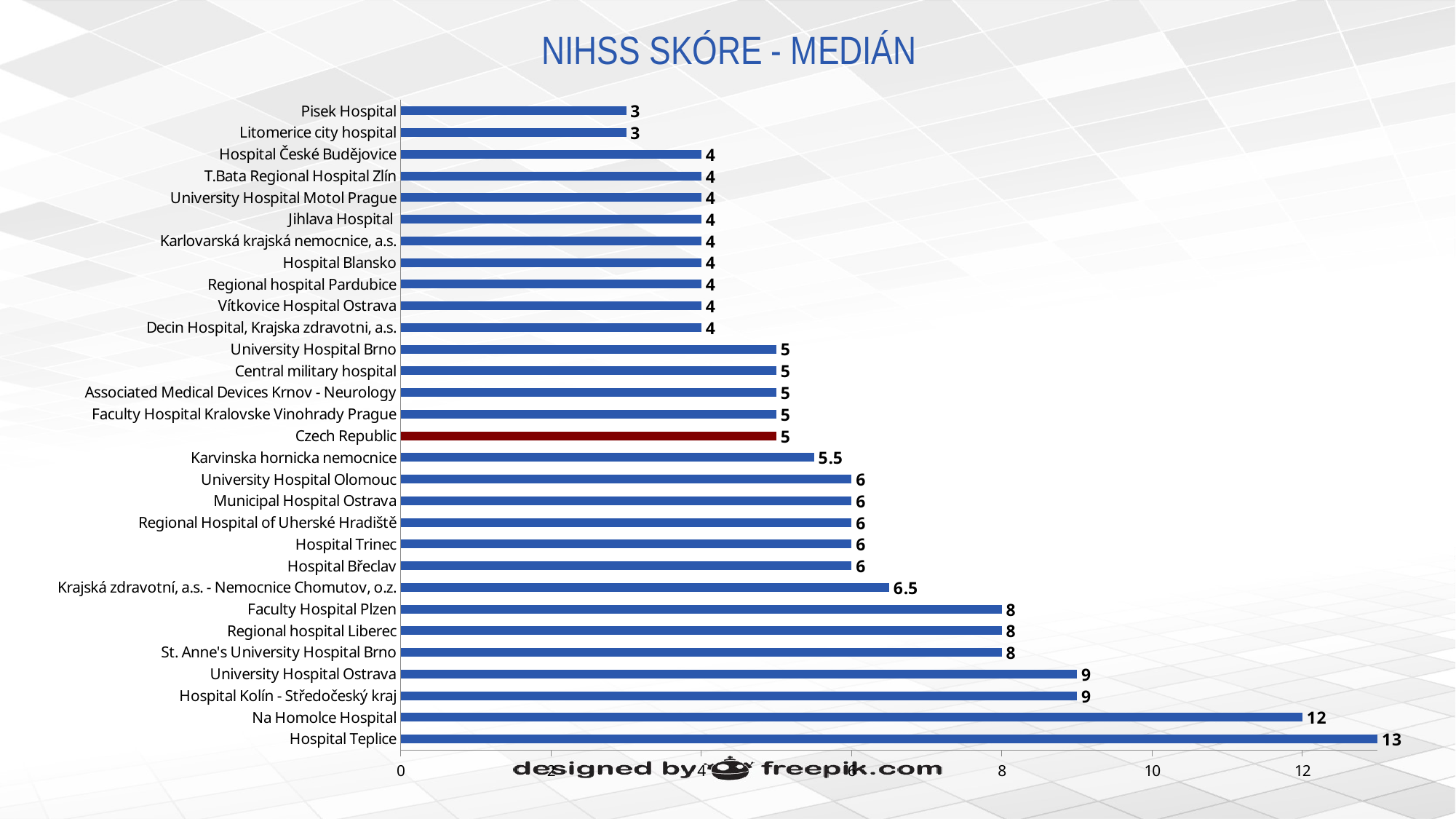
Which hospital has the highest NIHSS median score? Hospital Teplice What type of chart is shown on the slide? Bar chart What is the difference between the values for University Hospital Ostrava and Pisek Hospital? 6 What is the NIHSS median score for Hospital Teplice? 13 How many hospitals/categories are shown on the chart? 30 What is the lowest value shown on the chart? 3 What is the value for Karvinska hornicka nemocnice? 5.5 Which has a larger value, Faculty Hospital Plzen or University Hospital Olomouc? Faculty Hospital Plzen What is the value shown for Czech Republic? 5 What is the difference between the values for Hospital Teplice and Na Homolce Hospital? 1 What is the title of the chart? NIHSS SKÓRE - MEDIÁN What is the value for Krajská zdravotní, a.s. - Nemocnice Chomutov, o.z.? 6.5